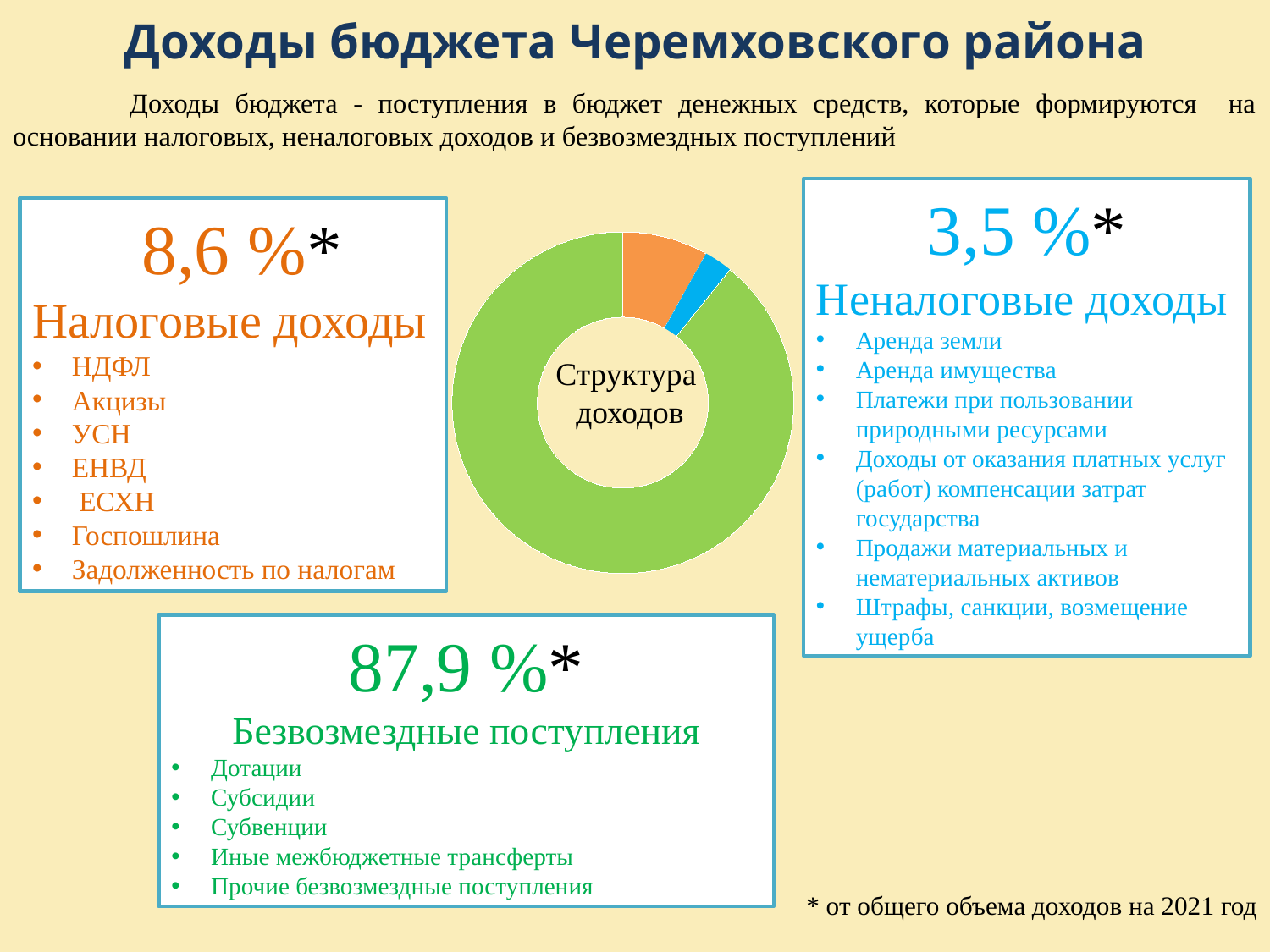
What share of total income do Неналоговые доходы make up? 3,5 % Which income category has the smallest slice of the donut chart? Неналоговые доходы By how many percentage points does the share of Налоговые доходы exceed the share of Неналоговые доходы? 5,1 % What kind of chart is shown in the centre of the slide? pie chart (donut) What share of total income do Безвозмездные поступления make up? 87,9 % Which income category has the largest slice of the donut chart? Безвозмездные поступления By how many percentage points does the share of Безвозмездные поступления exceed the share of Налоговые доходы? 79,3 % What colour is the slice representing Неналоговые доходы in the donut chart? blue What is the title shown in the centre of the donut chart? Структура доходов Which is larger: the share of Налоговые доходы or the share of Неналоговые доходы? Налоговые доходы How many slices does the donut chart have? 3 What share of total income do Налоговые доходы make up? 8,6 %